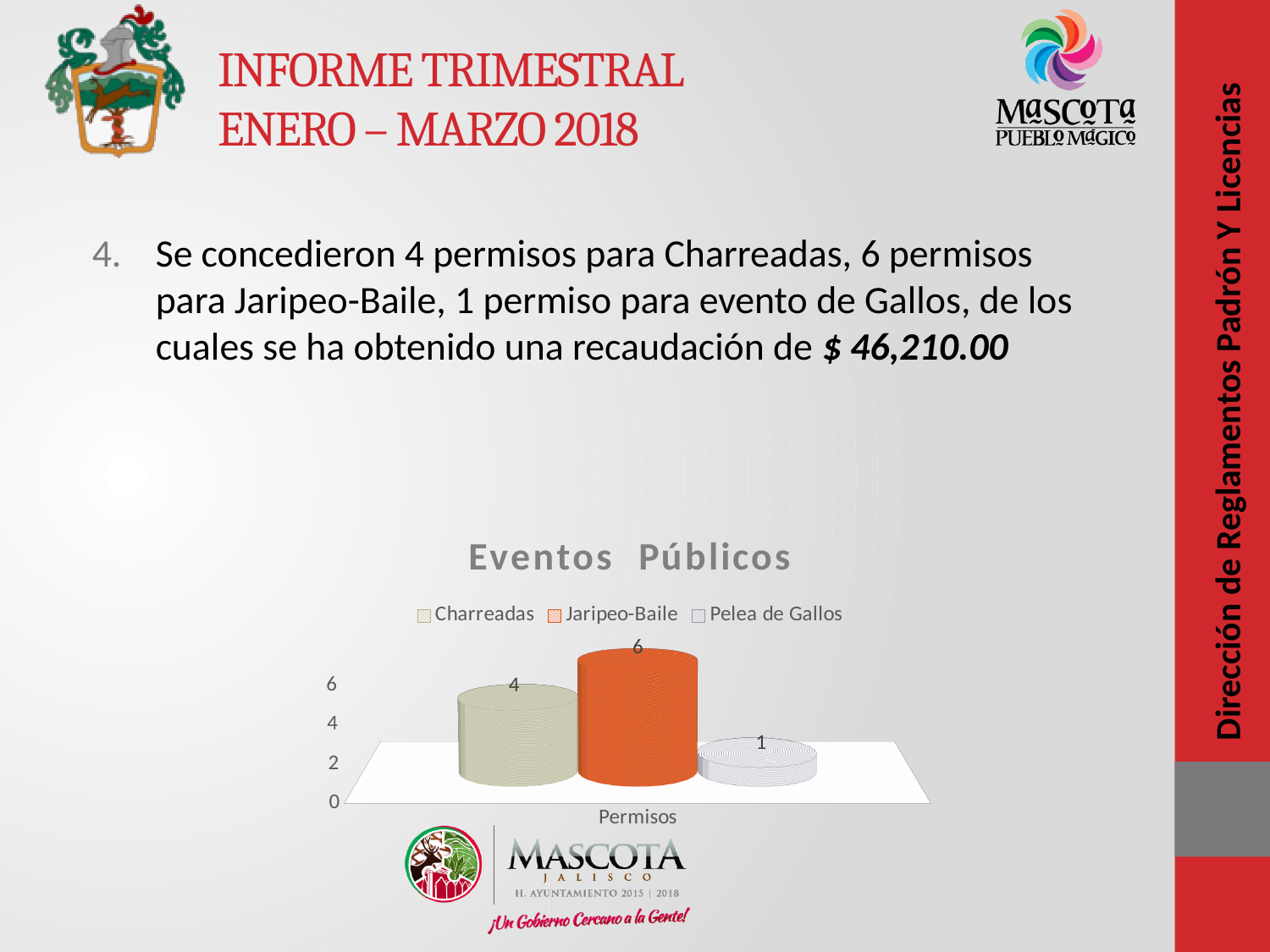
How many series does the legend of the Eventos Públicos chart list? 3 What is the value for Charreadas in the Eventos Públicos chart? 4 What is the value for Jaripeo-Baile in the Eventos Públicos chart? 6 What is the title of the chart on the slide? Eventos Públicos Which series has the highest value in the Eventos Públicos chart? Jaripeo-Baile Which is larger, the value for Charreadas or the value for Pelea de Gallos? Charreadas What is the difference between the values for Jaripeo-Baile and Charreadas? 2 What is the value for Pelea de Gallos in the Eventos Públicos chart? 1 What kind of chart is the Eventos Públicos chart? bar chart What is the category label on the x axis of the Eventos Públicos chart? Permisos What is the difference between the values for Charreadas and Pelea de Gallos? 3 Which series has the lowest value in the Eventos Públicos chart? Pelea de Gallos